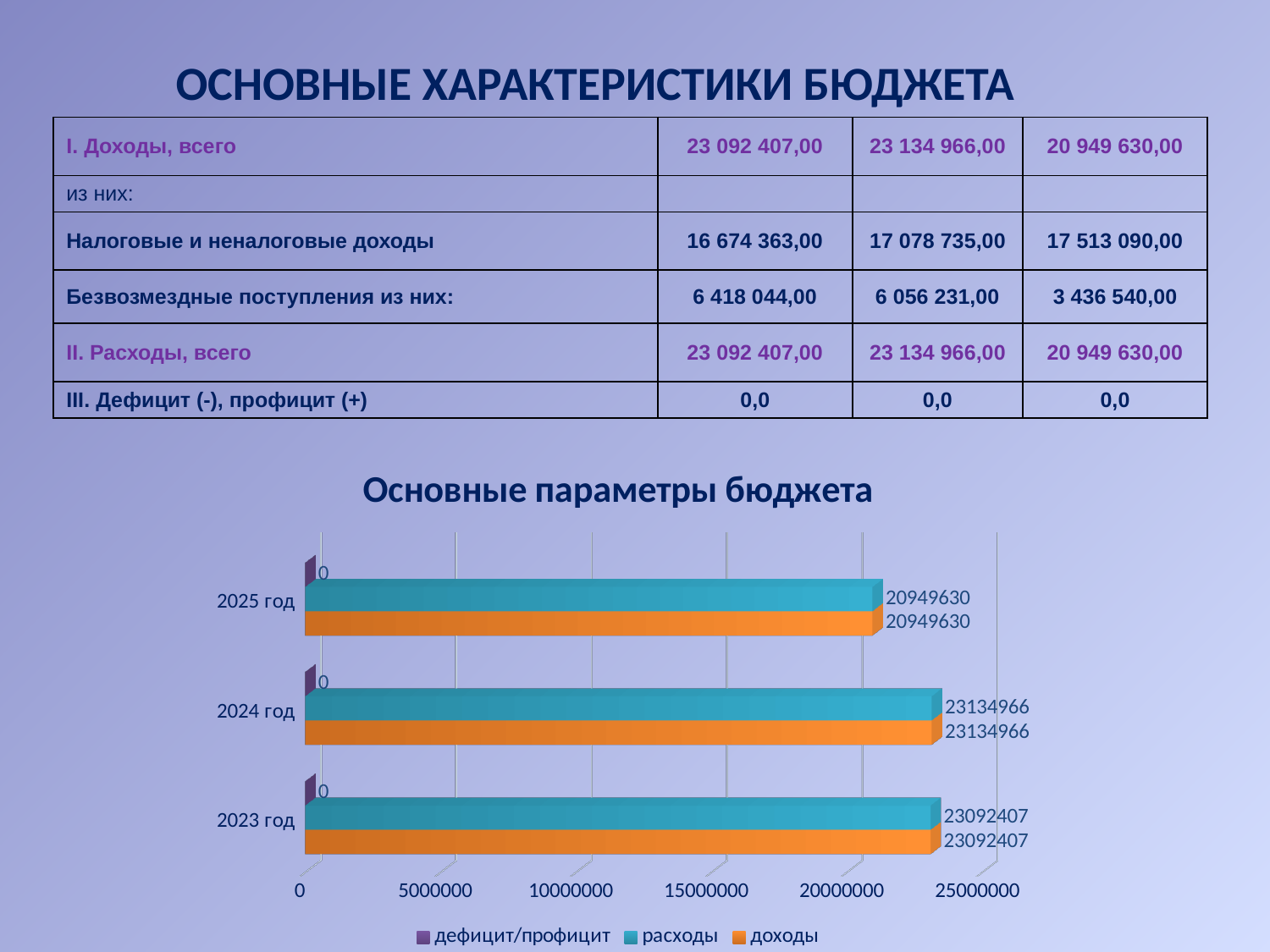
How many series does the legend of the chart "Основные параметры бюджета" list? 3 In the chart "Основные параметры бюджета", what is the value of дефицит/профицит for 2023 год? 0 In the chart "Основные параметры бюджета", what is the value of расходы for 2025 год? 20949630 In the chart "Основные параметры бюджета", is the value of расходы for 2023 год greater or less than 20000000? greater In the chart "Основные параметры бюджета", what is the value of доходы for 2024 год? 23134966 In the chart "Основные параметры бюджета", which year has the highest value of расходы? 2024 год In the chart "Основные параметры бюджета", which year has the lowest value of доходы? 2025 год In the chart "Основные параметры бюджета", what is the difference between доходы for 2024 год and доходы for 2025 год? 2185336 What type of chart is shown under the title "Основные параметры бюджета"? bar chart How many years (categories) are shown in the chart "Основные параметры бюджета"? 3 In the chart "Основные параметры бюджета", what is the value of расходы for 2023 год? 23092407 In the chart "Основные параметры бюджета", which series is shown in orange? доходы